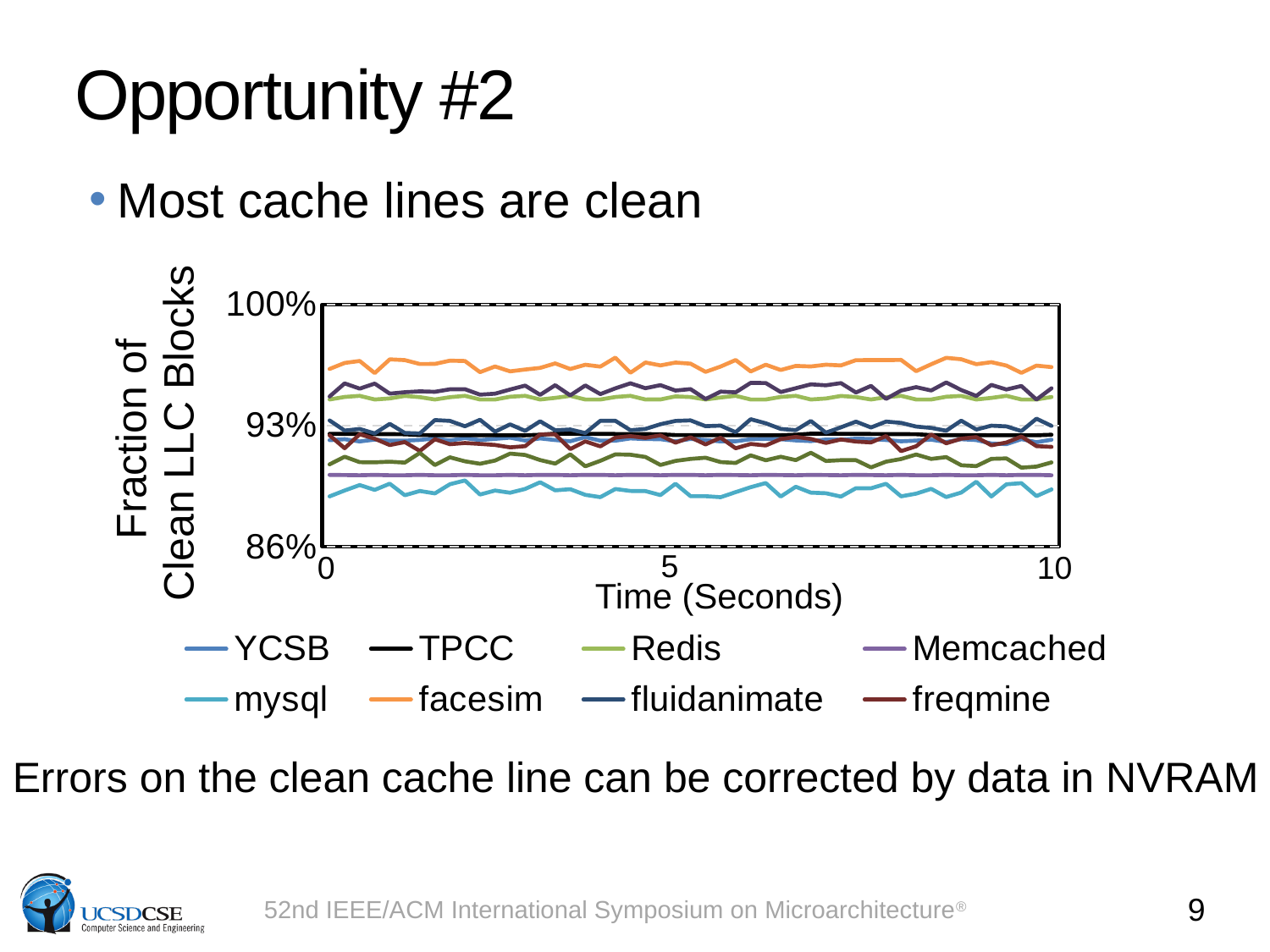
What is the label of the x axis? Time (Seconds) Which series has the highest fraction of clean LLC blocks throughout the chart? facesim Do the series values rise, fall, or stay roughly flat over time along the x axis? stay roughly flat Is the value for Memcached greater or less than 93%? less What kind of chart is shown on the slide? line chart How many series does the legend list? 8 Is the value for facesim greater or less than 93%? greater Which series has a higher fraction of clean LLC blocks, facesim or mysql? facesim Which series has a higher fraction of clean LLC blocks, Redis or Memcached? Redis Is the value for mysql greater or less than 93%? less Which series has the lowest fraction of clean LLC blocks throughout the chart? mysql